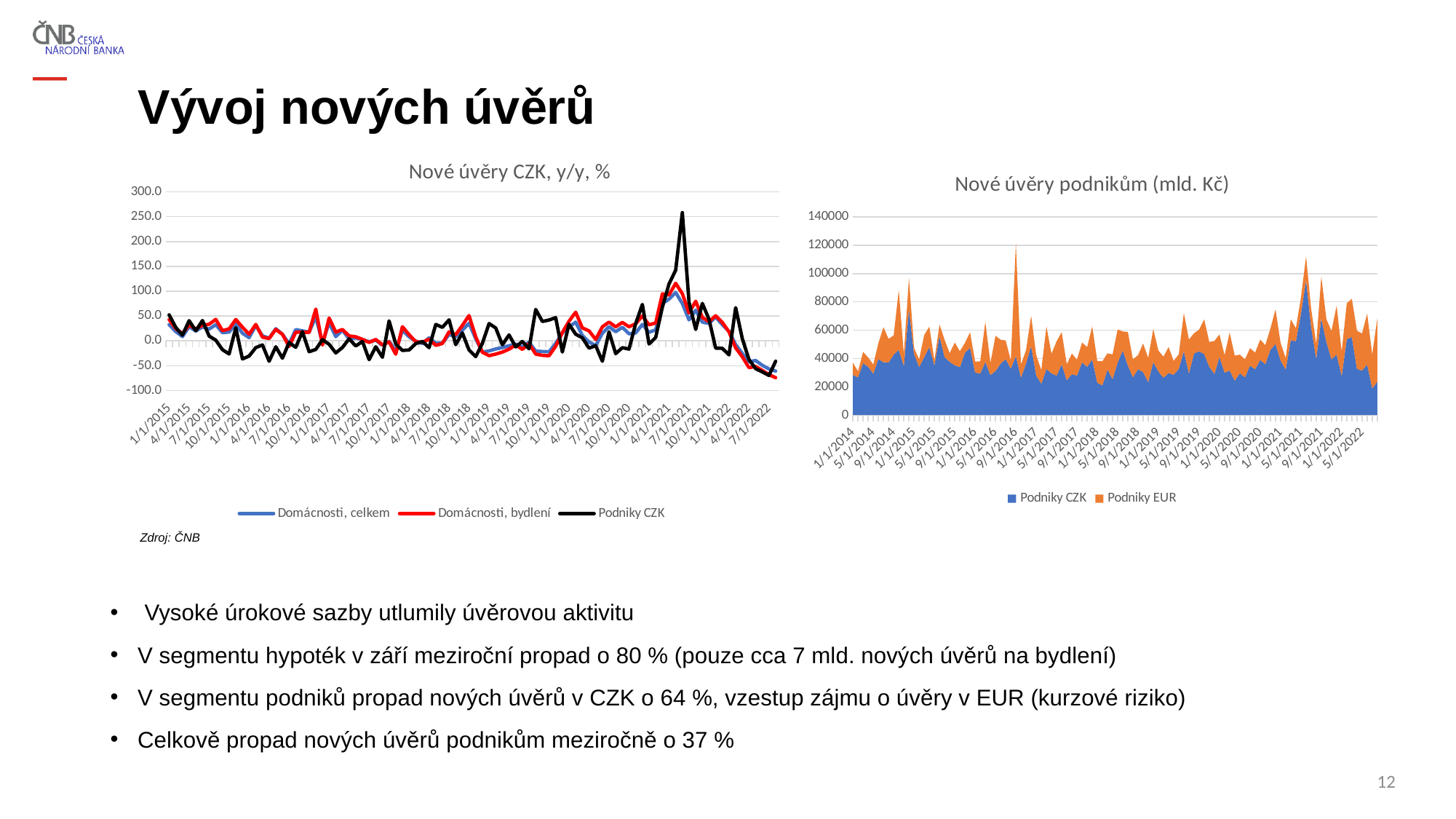
How many series does the legend of the left chart "Nové úvěry CZK, y/y, %" list? 3 In the right chart "Nové úvěry podnikům (mld. Kč)", is the highest value of the Podniky CZK series greater or less than 80000? greater How many series does the legend of the right chart "Nové úvěry podnikům (mld. Kč)" list? 2 What kind of chart is the left chart titled "Nové úvěry CZK, y/y, %"? line chart What kind of chart is the right chart titled "Nové úvěry podnikům (mld. Kč)"? stacked area chart In the left chart "Nové úvěry CZK, y/y, %", do the values of Podniky CZK rise or fall between 7/1/2021 and 7/1/2022? fall In the left chart "Nové úvěry CZK, y/y, %", which series reaches the highest value on the chart? Podniky CZK In the left chart "Nové úvěry CZK, y/y, %", is the peak value of the Podniky CZK series greater or less than 200? greater In the right chart "Nové úvěry podnikům (mld. Kč)", which colour represents the Podniky EUR series? orange In the right chart "Nové úvěry podnikům (mld. Kč)", is the highest stacked total greater or less than 140000? less What is the title of the left chart? Nové úvěry CZK, y/y, %